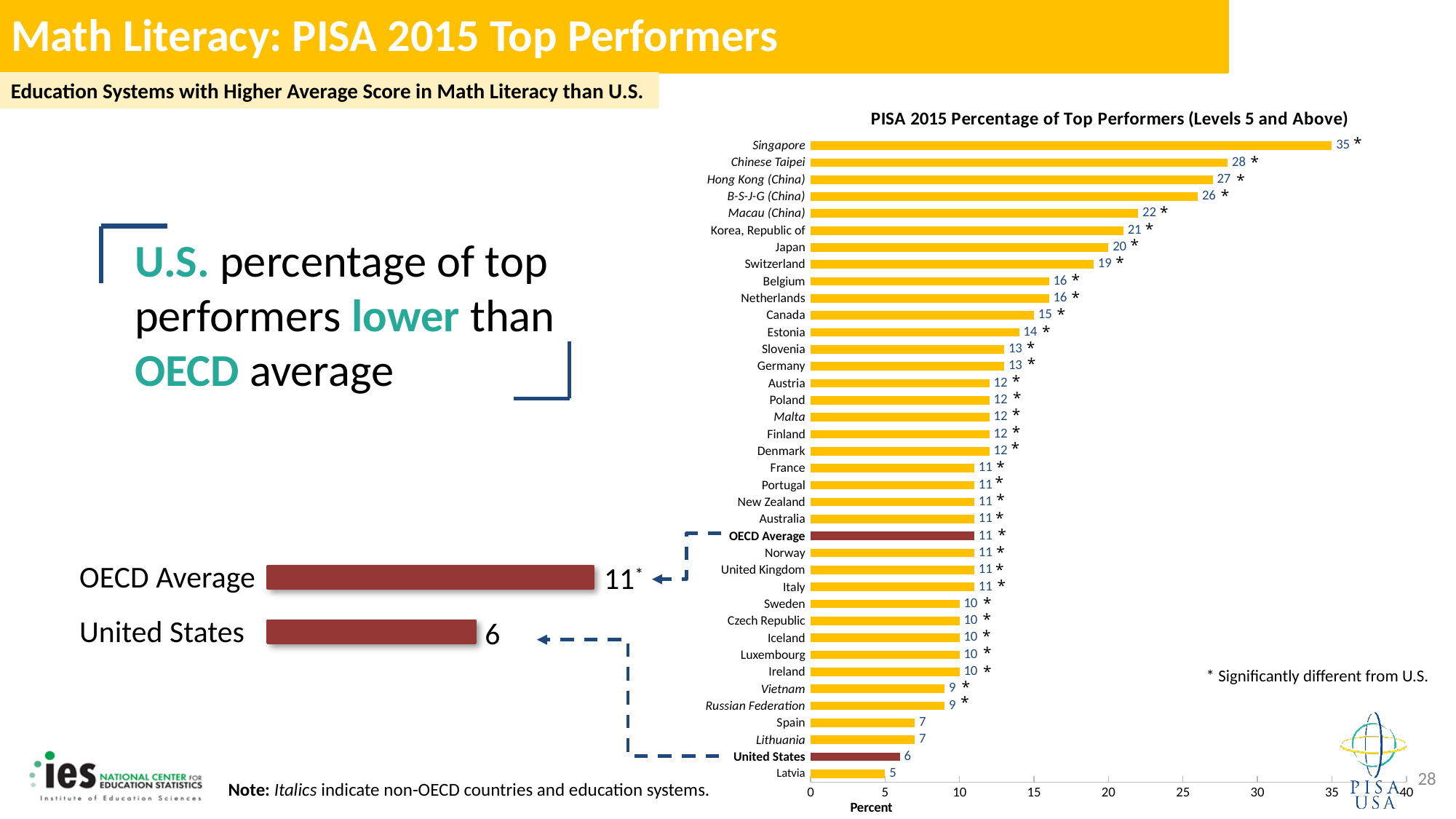
In the PISA 2015 Percentage of Top Performers chart, what is the value for Japan? 20 In the PISA 2015 Percentage of Top Performers chart, how many education systems (including the OECD Average) are listed? 38 What kind of chart is the PISA 2015 Percentage of Top Performers chart? bar chart In the PISA 2015 Percentage of Top Performers chart, is the value for Macau (China) greater or less than 20? greater In the PISA 2015 Percentage of Top Performers chart, which is larger, the value for Canada or the value for Estonia? Canada In the PISA 2015 Percentage of Top Performers chart, which education system has the lowest percentage of top performers? Latvia In the PISA 2015 Percentage of Top Performers chart, what is the value for Singapore? 35 In the small chart on the left of the slide, what is the value for the OECD Average? 11 In the PISA 2015 Percentage of Top Performers chart, which education system has the highest percentage of top performers? Singapore In the PISA 2015 Percentage of Top Performers chart, what is the difference between the OECD Average and the United States? 5 In the PISA 2015 Percentage of Top Performers chart, what is the difference between Singapore and Chinese Taipei? 7 In the PISA 2015 Percentage of Top Performers chart, what is the value for the United States? 6